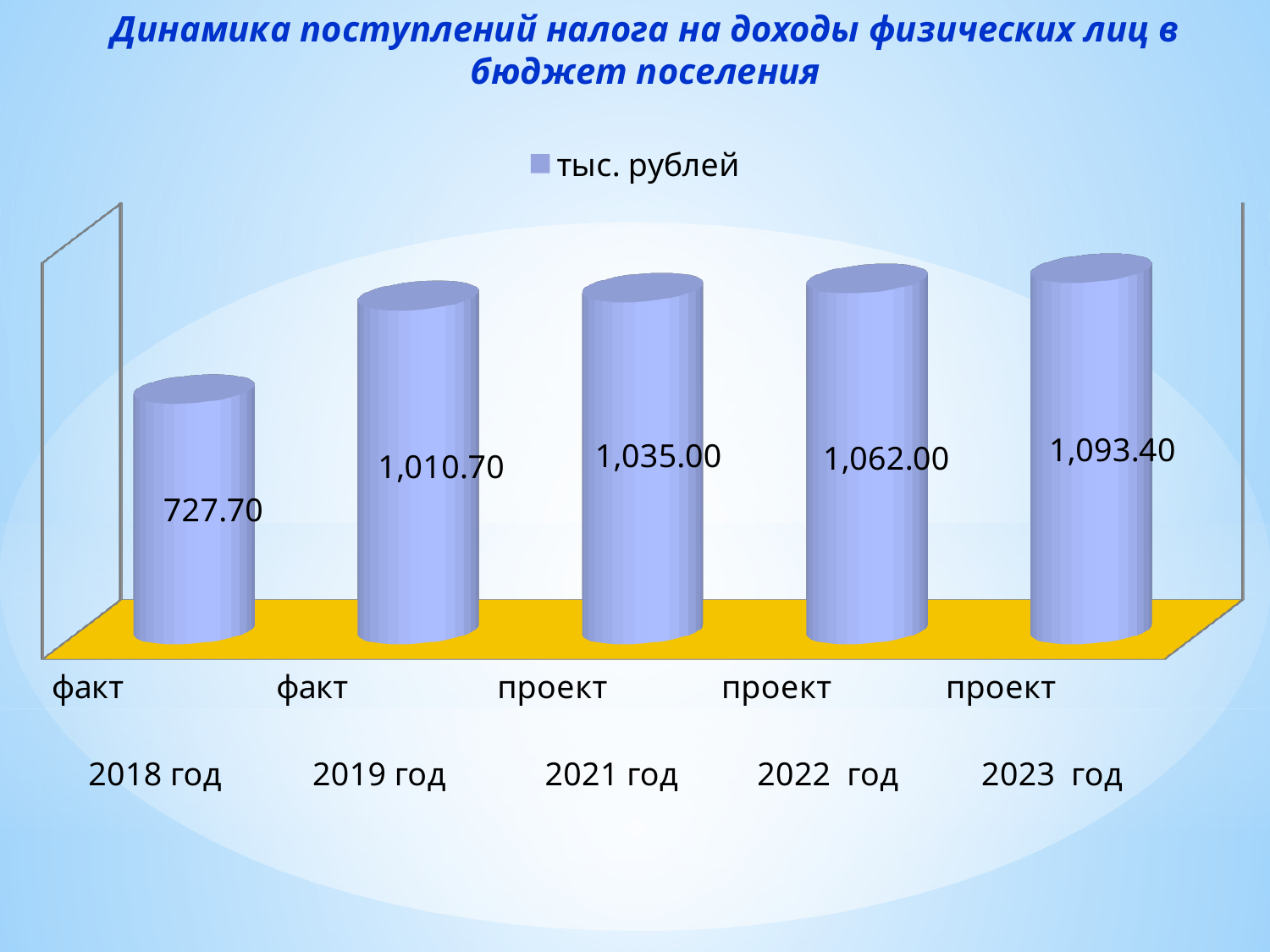
What is the value for 2023 год (проект)? 1,093.40 Which year has the lowest value? 2018 год How many series does the legend list? 1 Which is larger, the value for 2019 год or the value for 2022 год? 2022 год Which year has the highest value? 2023 год Do the values rise or fall from 2018 год to 2023 год? rise What is the value for 2018 год (факт)? 727.70 What is the difference between the values for 2023 год and 2022 год? 31.40 What is the difference between the values for 2019 год and 2018 год? 283.00 What kind of chart is shown on the slide? bar chart How many bars are shown in the chart? 5 What is the value for 2021 год (проект)? 1,035.00